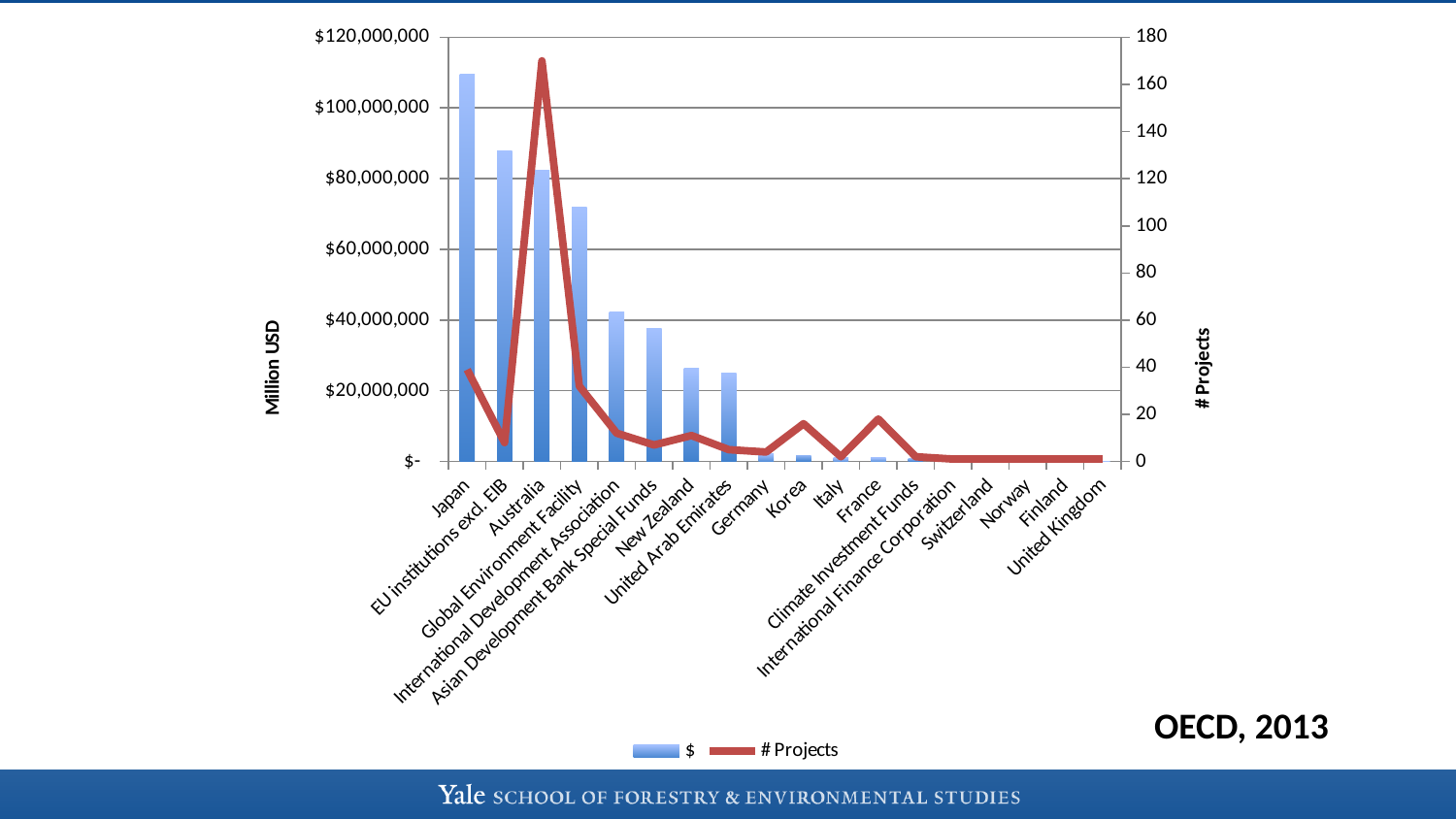
Which has a larger $ value, Japan or EU institutions excl. EIB? Japan Do the $ bar values generally rise or fall from left to right along the x axis? fall Is the # Projects value for Australia greater or less than 160? greater Is the $ value for Global Environment Facility greater or less than $60,000,000? greater How many categories are shown along the x axis? 18 What kind of chart is shown on the slide? A combined bar and line chart Which category has the highest value for the $ series? Japan Which category has the highest value for the # Projects series? Australia Is the $ value for Asian Development Bank Special Funds greater or less than $40,000,000? less How many series does the legend list? 2